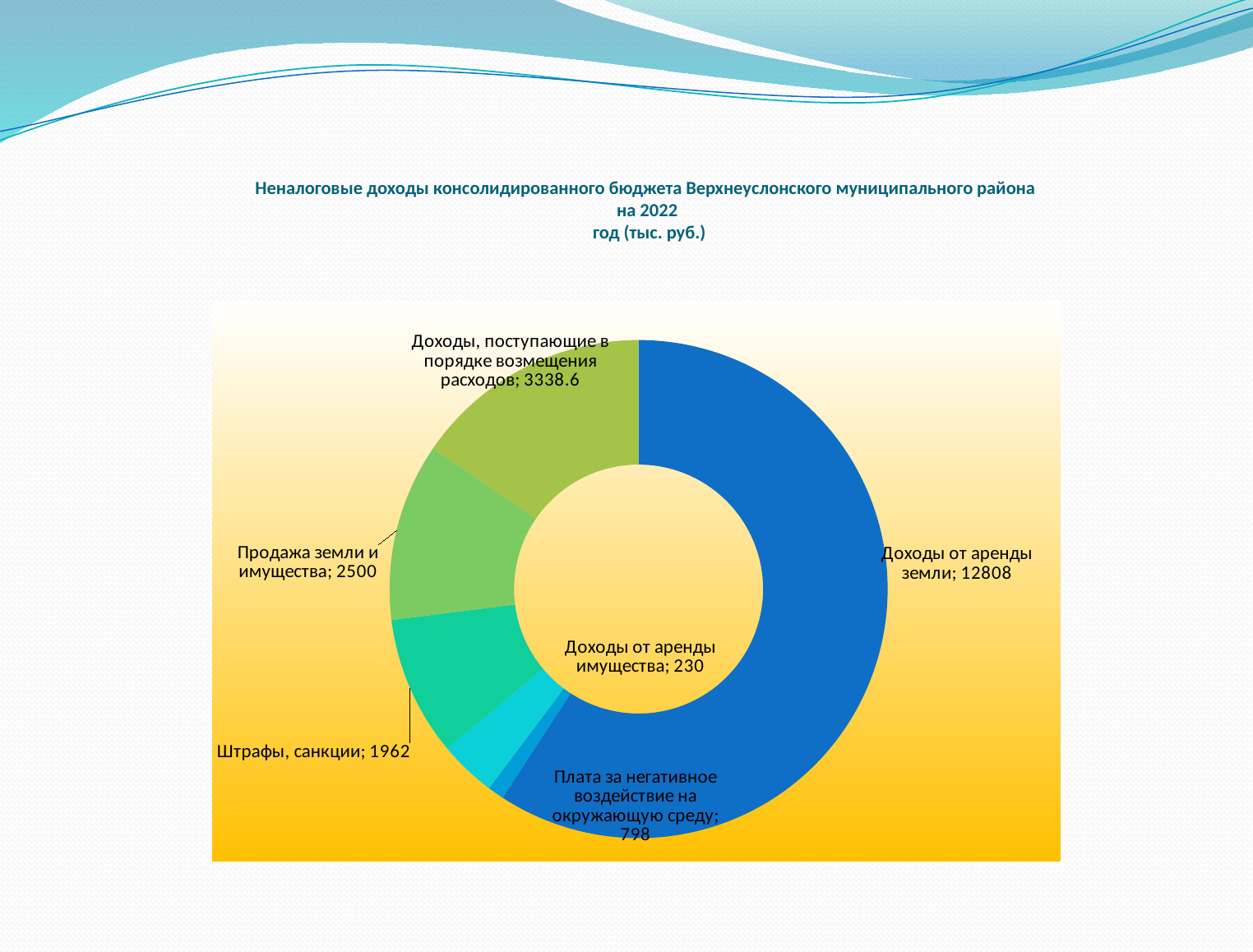
What is the difference between Доходы от аренды земли and Доходы, поступающие в порядке возмещения расходов? 9469.4 What is the value for Доходы, поступающие в порядке возмещения расходов? 3338.6 What is the value for Доходы от аренды земли? 12808 What is the value for Плата за негативное воздействие на окружающую среду? 798 What is the value for Штрафы, санкции? 1962 What kind of chart is shown on the slide? doughnut chart What is the total of all categories shown in the chart? 21636.6 Which category has the highest value? Доходы от аренды земли How many categories are shown in the chart? 6 Which is larger: Плата за негативное воздействие на окружающую среду or Доходы от аренды имущества? Плата за негативное воздействие на окружающую среду Which category has the lowest value? Доходы от аренды имущества What is the difference between Продажа земли и имущества and Штрафы, санкции? 538